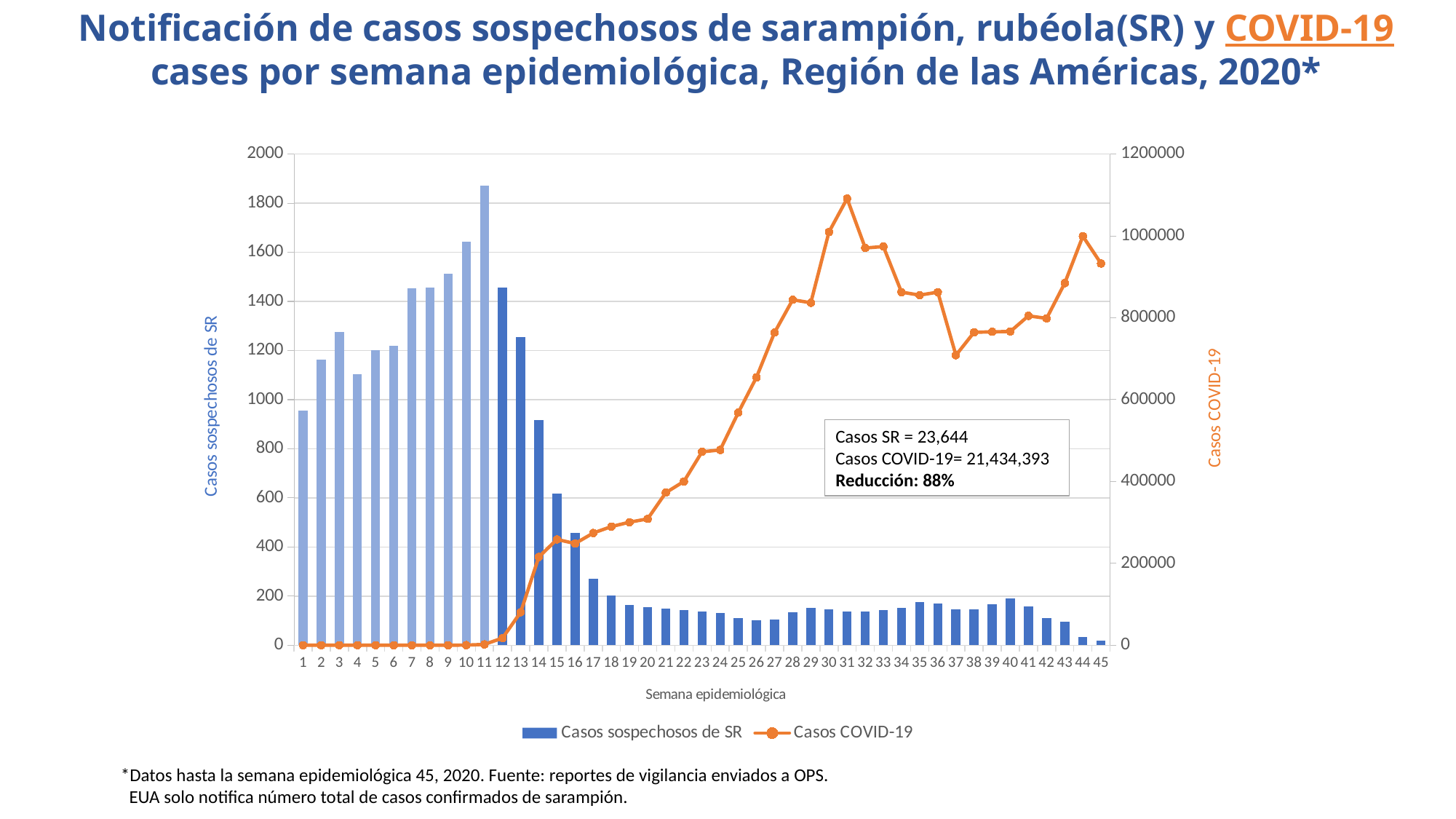
According to the text box on the chart, what is the stated reduction? 88% How many epidemiological weeks are plotted on the x axis? 45 How many series does the legend list? 2 In which epidemiological week is the number of suspected SR cases (bars) highest? 11 In which epidemiological week does the COVID-19 line reach its highest point? 31 What kind of chart is shown on the slide? A combined bar and line chart Is the value of COVID-19 cases for week 31 greater or less than 1000000? greater Which week has more suspected SR cases, week 3 or week 4? Week 3 Do the suspected SR cases (bars) rise or fall from week 11 to week 17? Fall In which epidemiological week is the number of suspected SR cases (bars) lowest? 45 Is the value of suspected SR cases for week 11 greater or less than 1800? greater Is the value of suspected SR cases for week 1 greater or less than 1000? less